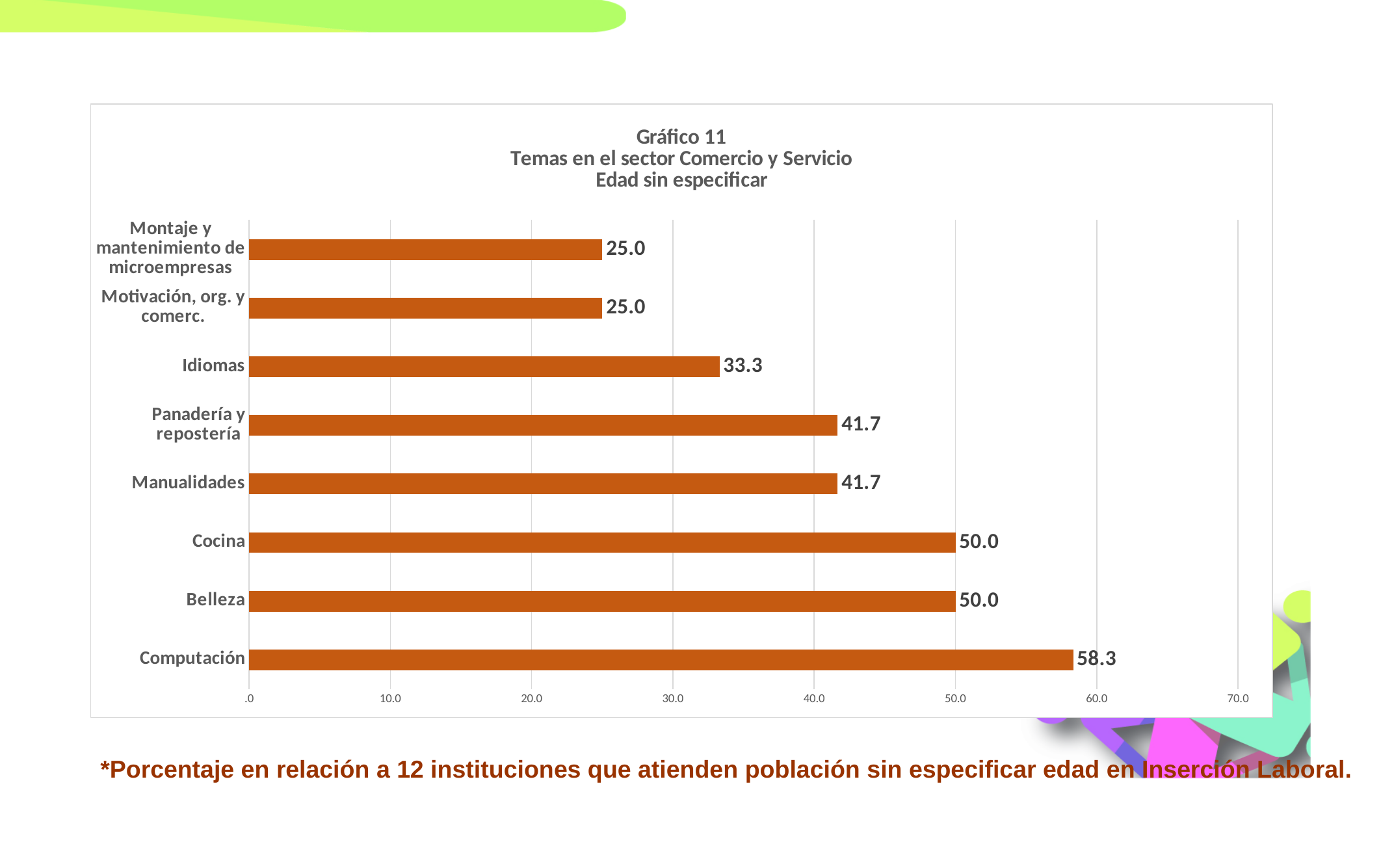
Is the value for Computación greater or less than 50.0? greater Which category has the highest value? Computación What is the difference between the values for Computación and Cocina? 8.3 How many categories are shown in the chart? 8 What is the value for Panadería y repostería? 41.7 What is the value for Computación? 58.3 What is the title of the chart? Gráfico 11 Temas en el sector Comercio y Servicio Edad sin especificar What kind of chart is shown on the slide? Bar chart What is the value for Motivación, org. y comerc.? 25.0 Which is larger, the value for Belleza or the value for Idiomas? Belleza What is the difference between the values for Manualidades and Idiomas? 8.4 What is the value for Idiomas? 33.3